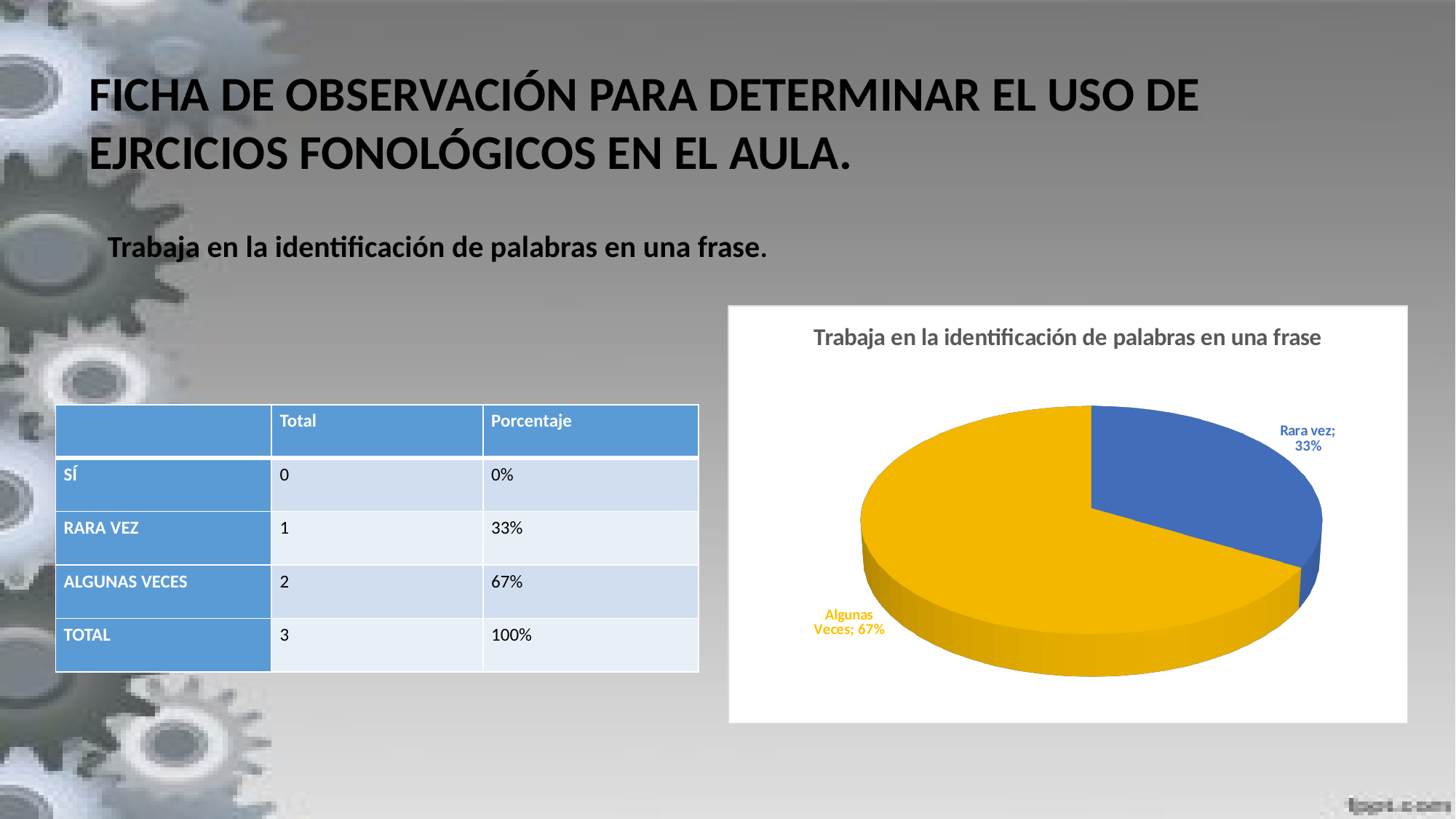
What is the difference in percentage points between the 'Algunas Veces' slice and the 'Rara vez' slice? 34 Is the share for 'Algunas Veces' greater or less than 50%? greater What share of the pie does the 'Algunas Veces' slice represent? 67% What colour is the 'Rara vez' slice? Blue What share of the pie does the 'Rara vez' slice represent? 33% What type of chart is shown on the slide? Pie chart Which is larger, the 'Rara vez' slice or the 'Algunas Veces' slice? Algunas Veces How many slices are labelled in the pie chart? 2 Which slice of the pie is the largest? Algunas Veces Which slice of the pie is the smallest? Rara vez What is the title of the chart? Trabaja en la identificación de palabras en una frase